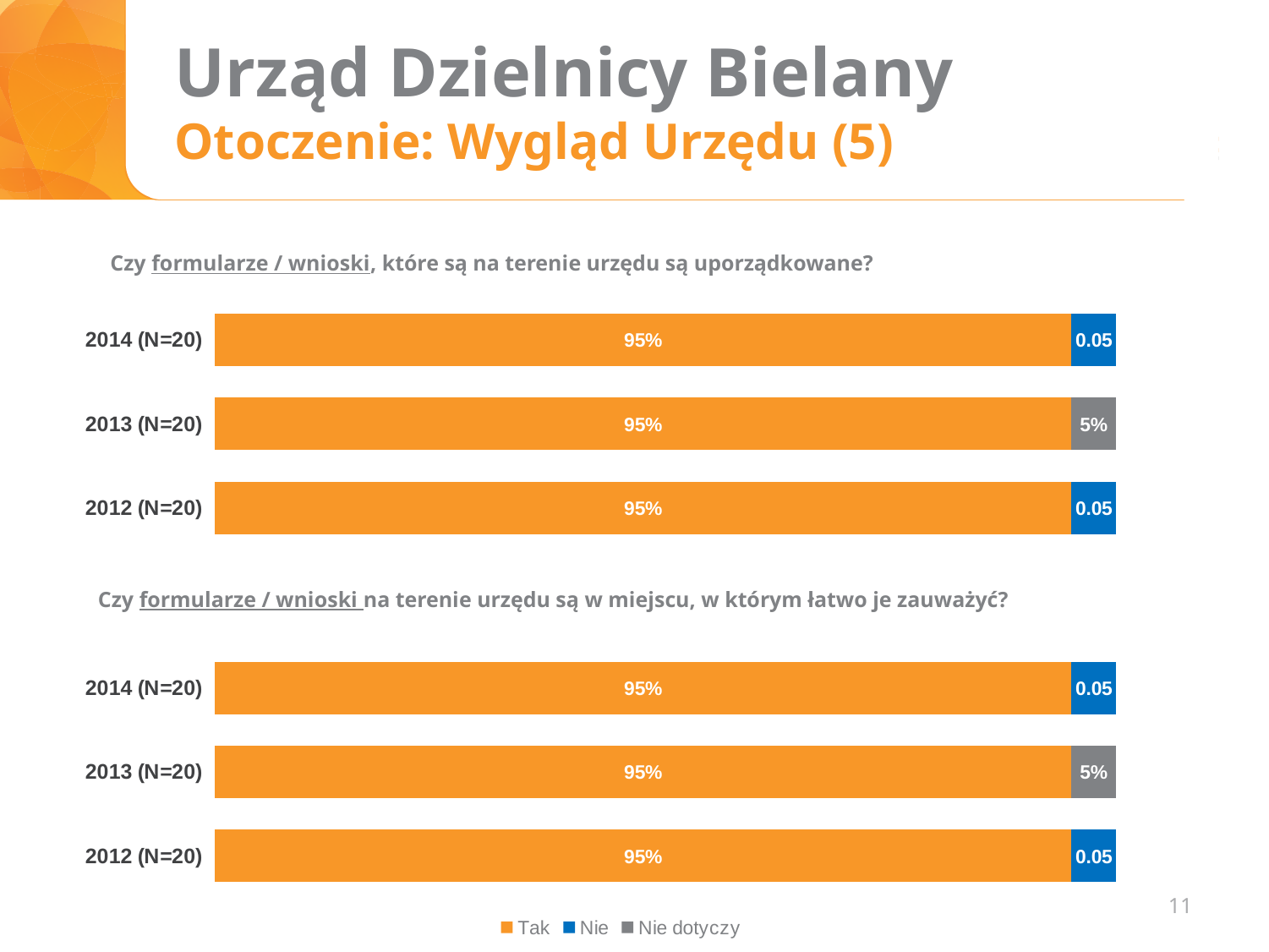
In the bottom chart, does the value for Tak change across 2012, 2013 and 2014? No, it stays at 95% In the bottom chart, what is the value labelled on the blue Nie segment for 2014 (N=20)? 0.05 How many series does the legend at the bottom of the slide list? 3 In the bottom chart ("Czy formularze / wnioski na terenie urzędu są w miejscu, w którym łatwo je zauważyć?"), what is the value for Tak in 2013 (N=20)? 95% Which legend entry is shown in orange? Tak In the top chart, what is the value for Nie dotyczy in 2013 (N=20)? 5% What kind of chart is the bottom chart? Stacked horizontal bar chart In the top chart, what is the value labelled on the blue Nie segment for 2012 (N=20)? 0.05 In the top chart, which is larger for 2013 (N=20): Tak or Nie dotyczy? Tak In the top chart ("Czy formularze / wnioski, które są na terenie urzędu są uporządkowane?"), what is the value for Tak in 2014 (N=20)? 95% How many year categories does the top chart show? 3 In the bottom chart, what is the value for Nie dotyczy in 2013 (N=20)? 5%